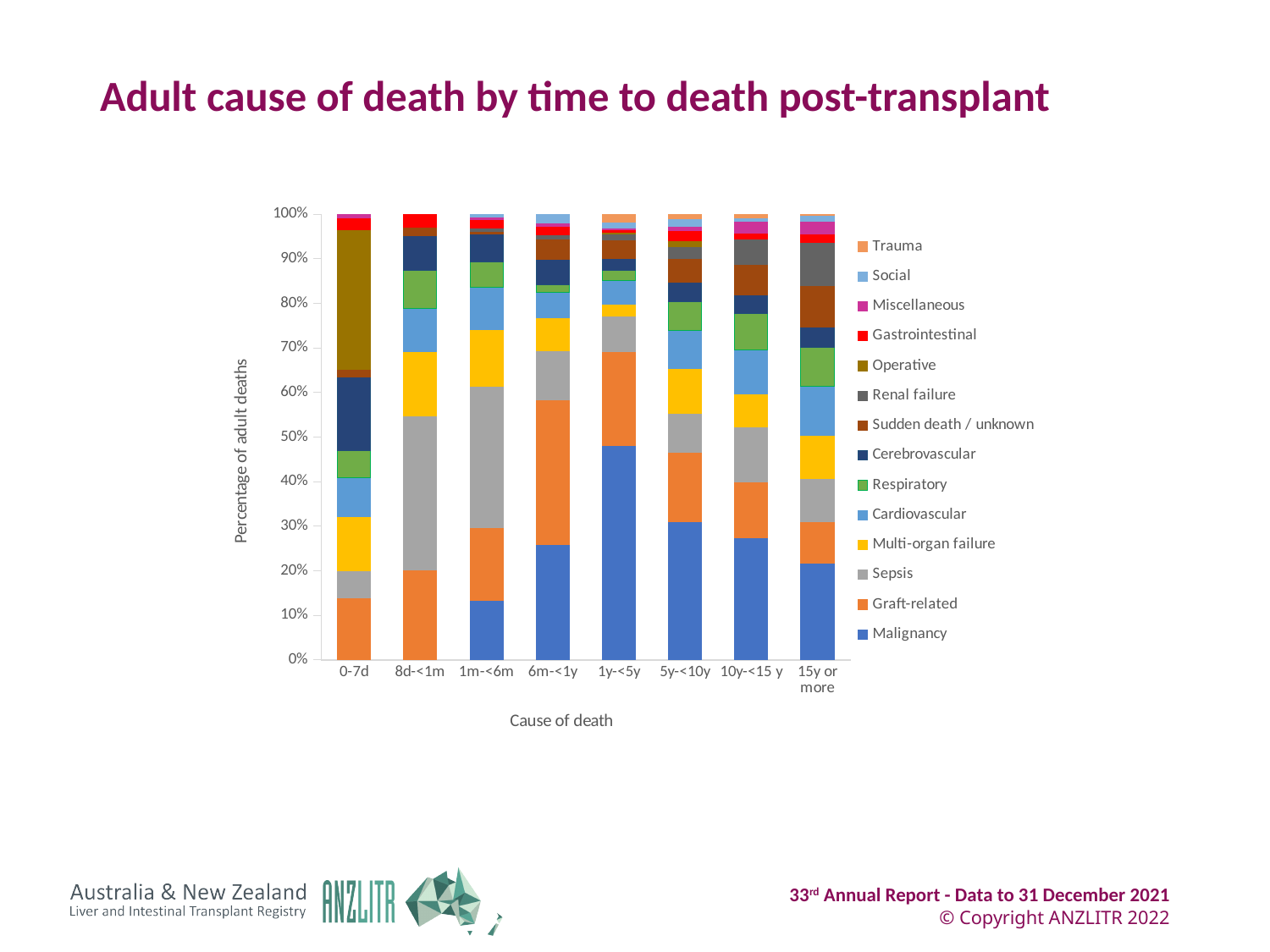
What is the total of the stacked bar for the 1y-<5y category? 100% How many time-to-death categories are shown on the x axis? 8 How many series does the legend list? 14 Is the Sepsis value for the 8d-<1m category greater or less than 30%? greater What kind of chart is shown on the slide? Stacked bar chart Is the Malignancy value for the 1y-<5y category greater or less than 50%? less Which time-to-death category has the largest Malignancy segment? 1y-<5y What is the label of the y axis? Percentage of adult deaths What is the title of the chart? Adult cause of death by time to death post-transplant Is the Malignancy segment larger for the 1y-<5y category or the 15y or more category? 1y-<5y Is the Malignancy value for the 1m-<6m category greater or less than 10%? greater